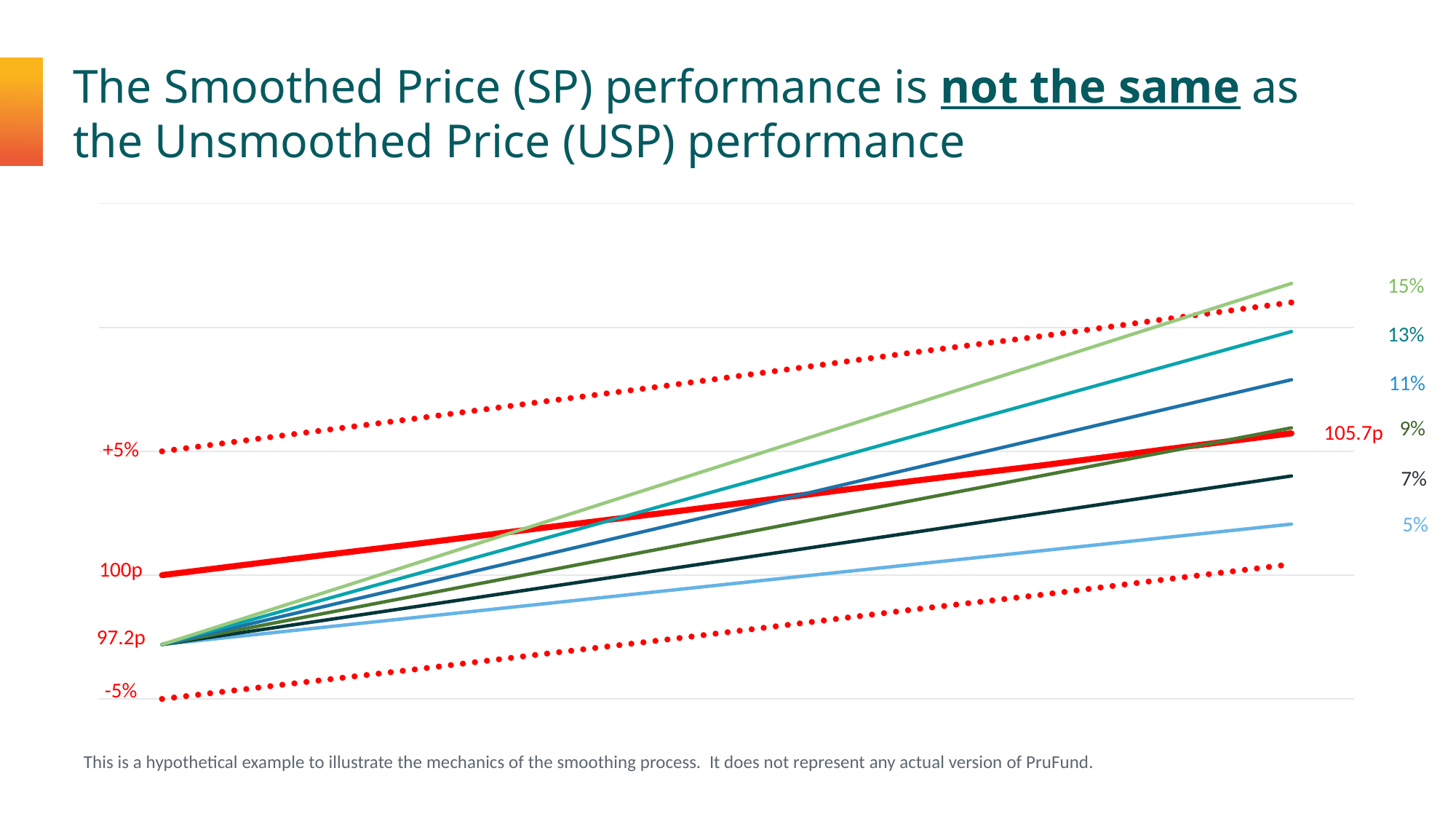
How many coloured lines end with a percentage label on the right of the chart? 6 Does the thick solid red line rise or fall from left to right? Rise What is the difference between the thick red line's end value (105.7p) and its start value (100p)? 5.7p Which ends higher on the right of the chart, the light green line or the light blue line? The light green line (15%) What is the starting value labelled on the left where the fan of coloured lines begins? 97.2p What is the starting value of the thick solid red line on the left of the chart? 100p What percentage labels mark the upper and lower dotted red lines on the left of the chart? +5% and -5% What is the end value labelled at the right of the thick solid red line? 105.7p What is the lowest percentage labelled at the right-hand end of the coloured lines? 5% What is the highest percentage labelled at the right-hand end of the coloured lines? 15% What kind of chart is shown on the slide? Line chart What is the difference between the 100p start of the red line and the 97.2p start of the coloured lines? 2.8p